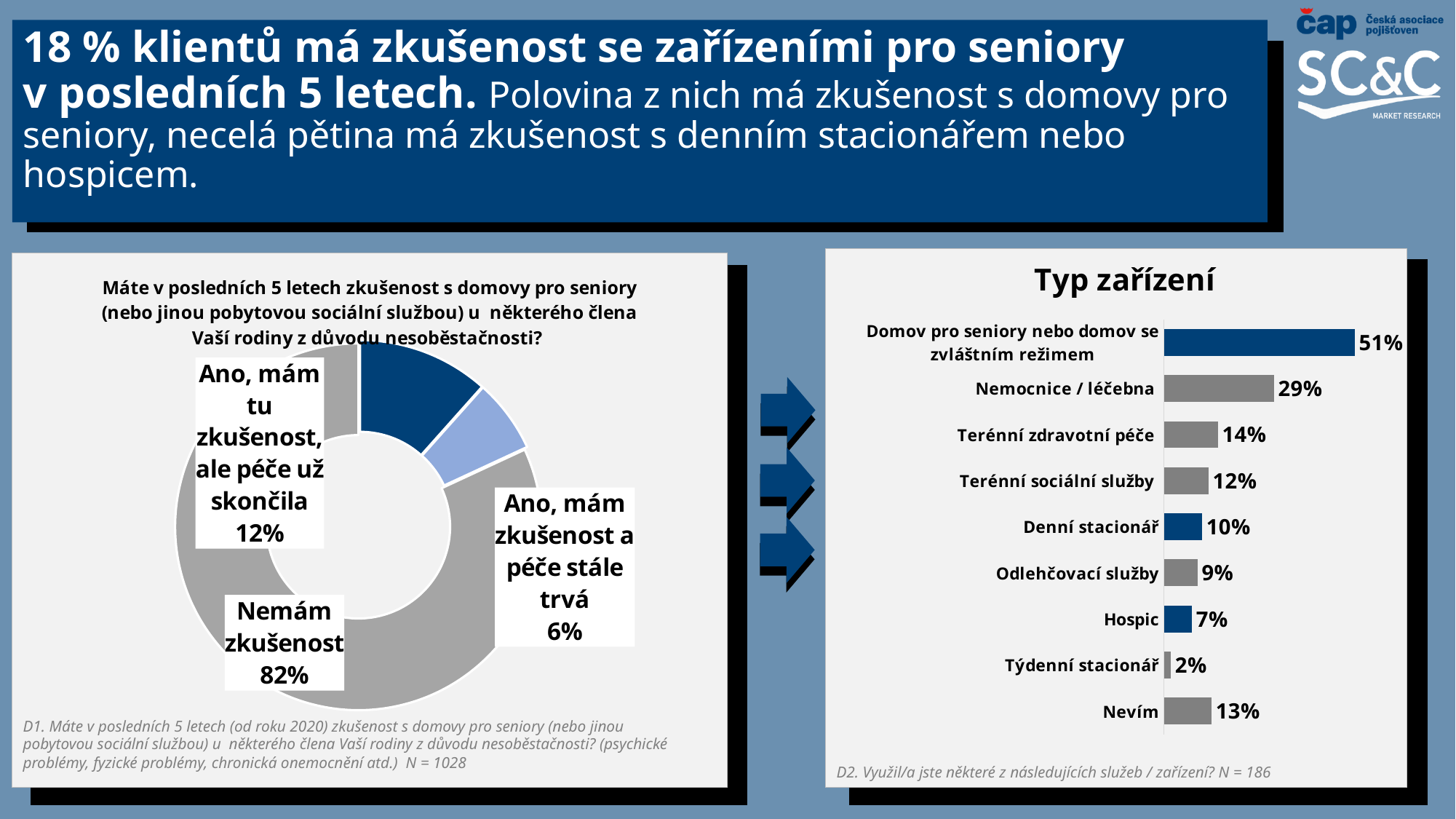
In the 'Typ zařízení' chart, which is larger: Denní stacionář or Nevím? Nevím In the 'Typ zařízení' chart, what is the difference between the values for Domov pro seniory nebo domov se zvláštním režimem and Nemocnice / léčebna? 22 percentage points In the donut chart on the left, what is the difference between 'Ano, mám tu zkušenost, ale péče už skončila' and 'Ano, mám zkušenost a péče stále trvá'? 6 percentage points In the donut chart on the left, what is the value for 'Ano, mám zkušenost a péče stále trvá'? 6% What is the title of the bar chart on the right side of the slide? Typ zařízení In the 'Typ zařízení' chart, which category has the highest value? Domov pro seniory nebo domov se zvláštním režimem In the 'Typ zařízení' chart, what is the value for Nemocnice / léčebna? 29% What kind of chart is the 'Typ zařízení' chart on the right? Bar chart In the donut chart on the left, what share is labelled 'Nemám zkušenost'? 82% In the 'Typ zařízení' chart, which category has the lowest value? Týdenní stacionář How many categories are shown in the 'Typ zařízení' chart? 9 In the 'Typ zařízení' chart, what is the value for Hospic? 7%